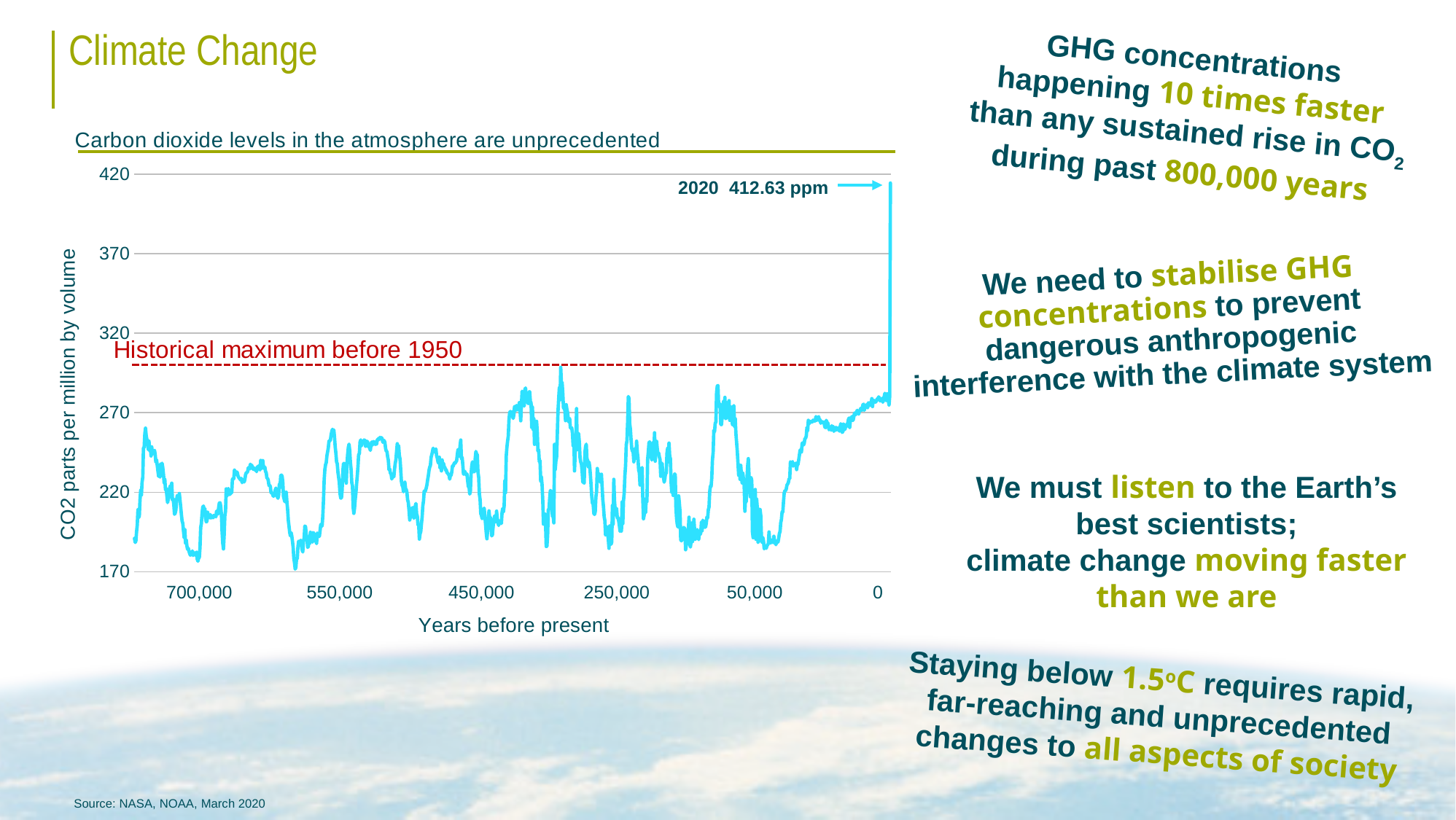
What CO2 level is labelled for the year 2020 on the chart? 412.63 ppm Is the 2020 value on the chart greater or less than 370? greater What is the label on the vertical axis of the chart? CO2 parts per million by volume How many labelled tick marks are shown on the horizontal axis of the chart? 6 Is the lowest point of the CO2 line on the chart greater or less than 220? less At which labelled point does the CO2 line reach its highest value? 2020 Is the 2020 value on the chart greater or less than the 'Historical maximum before 1950' line? greater Is the value of the CO2 line at 700,000 years before present greater or less than 270? less What kind of chart is shown on the slide? line chart What is the title of the chart? Carbon dioxide levels in the atmosphere are unprecedented